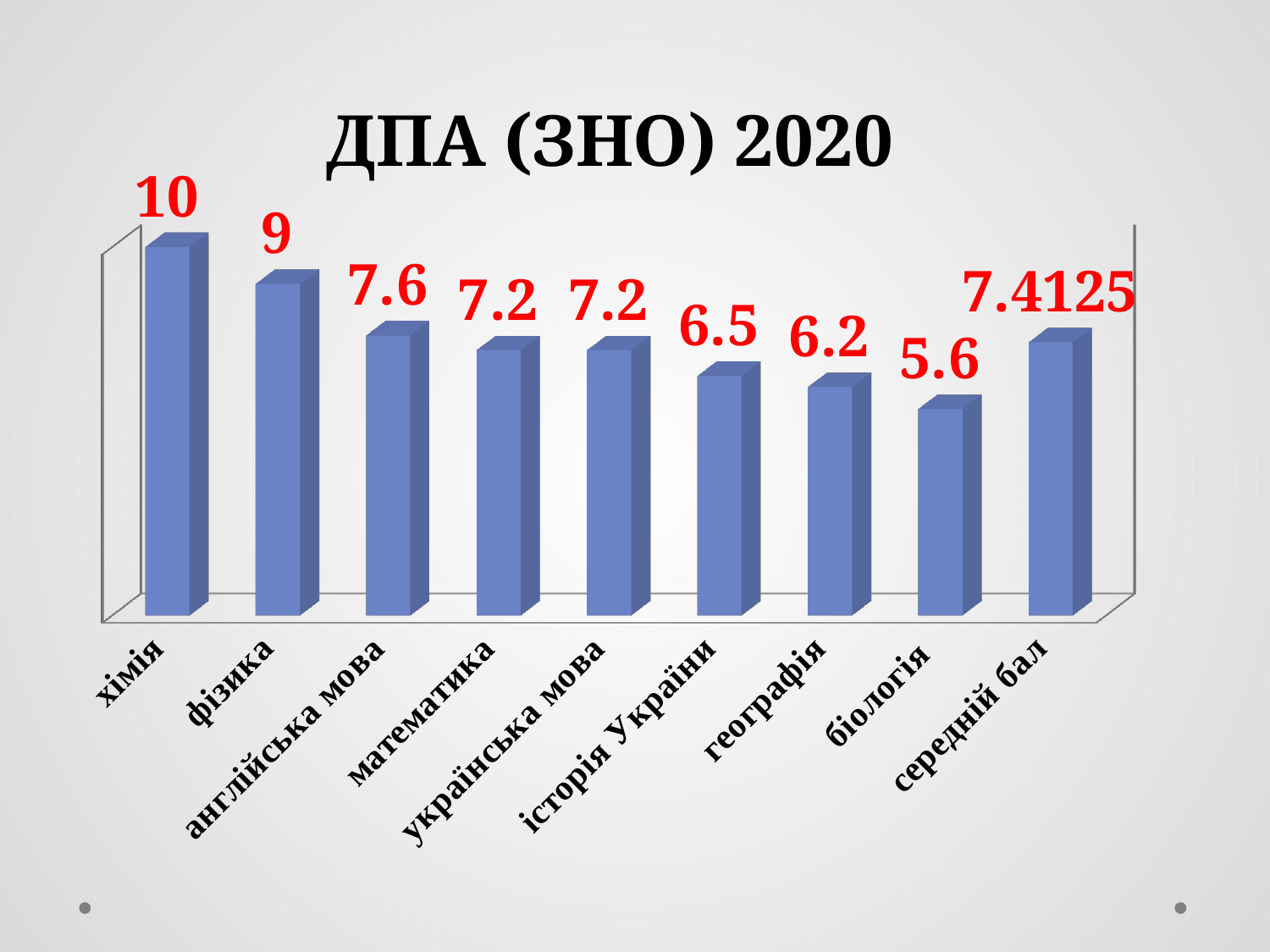
Do the values for математика and українська мова differ? No, both are 7.2 What is the value for середній бал? 7.4125 What is the difference between the values for фізика and географія? 2.8 How many categories are shown on the x axis? 9 Which is larger, the value for англійська мова or the value for математика? англійська мова Which category has the lowest value? біологія What is the value for біологія? 5.6 What is the value for історія України? 6.5 What is the value for хімія? 10 What is the title of the chart? ДПА (ЗНО) 2020 What kind of chart is shown on the slide? bar chart Which category has the highest value? хімія